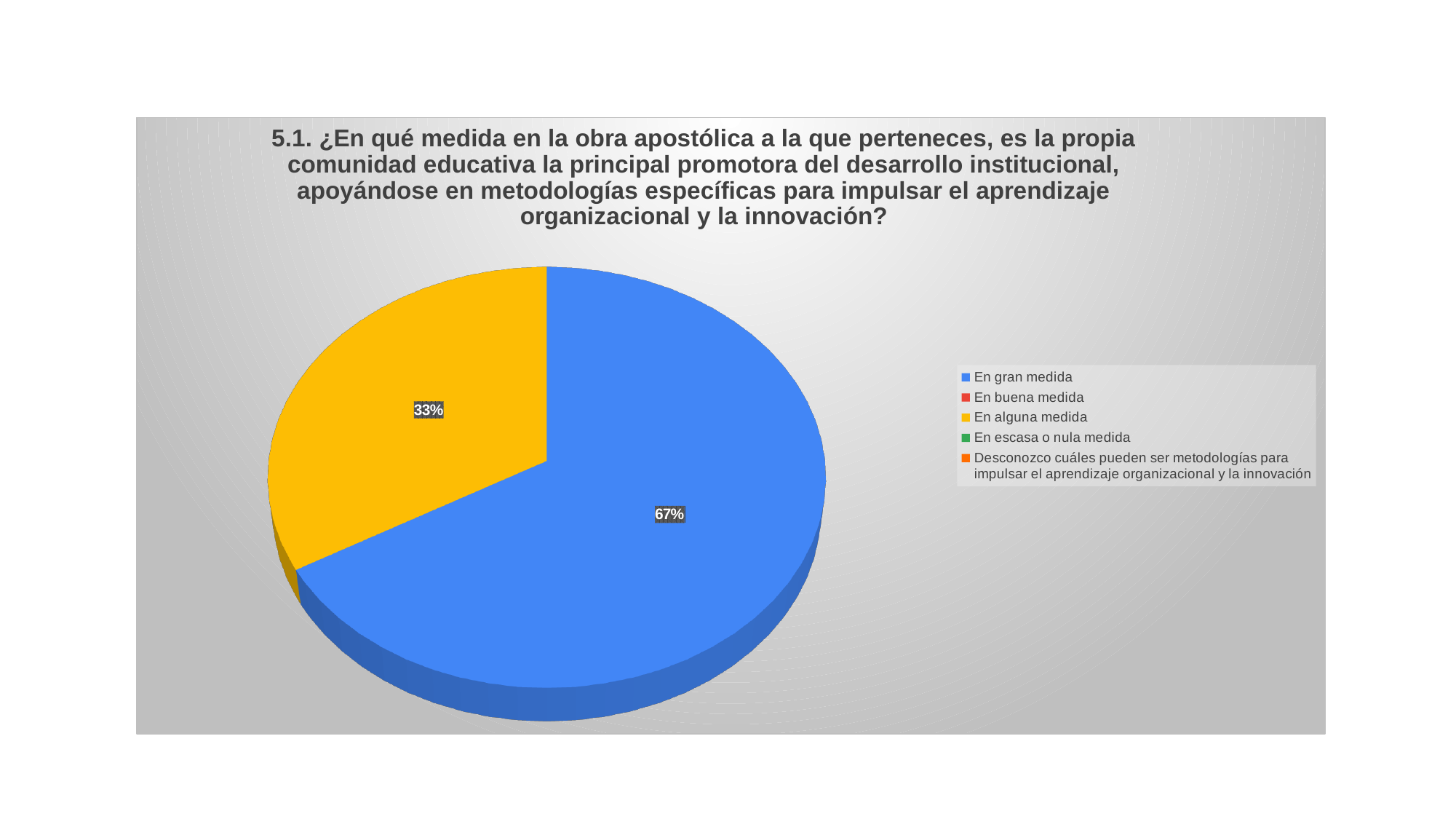
Which of the two visible slices is larger, "En gran medida" or "En alguna medida"? En gran medida What colour is the "En gran medida" slice? blue What colour is the "En alguna medida" slice? yellow What share of the pie does "En alguna medida" have? 33% Is the share for "En gran medida" greater or less than 50%? greater What is the difference in percentage points between the "En gran medida" slice and the "En alguna medida" slice? 34% How many slices are visible in the pie? 2 How many entries does the legend list? 5 What kind of chart is shown on the slide? pie chart Which category has the largest slice of the pie? En gran medida What share of the pie does "En gran medida" have? 67%